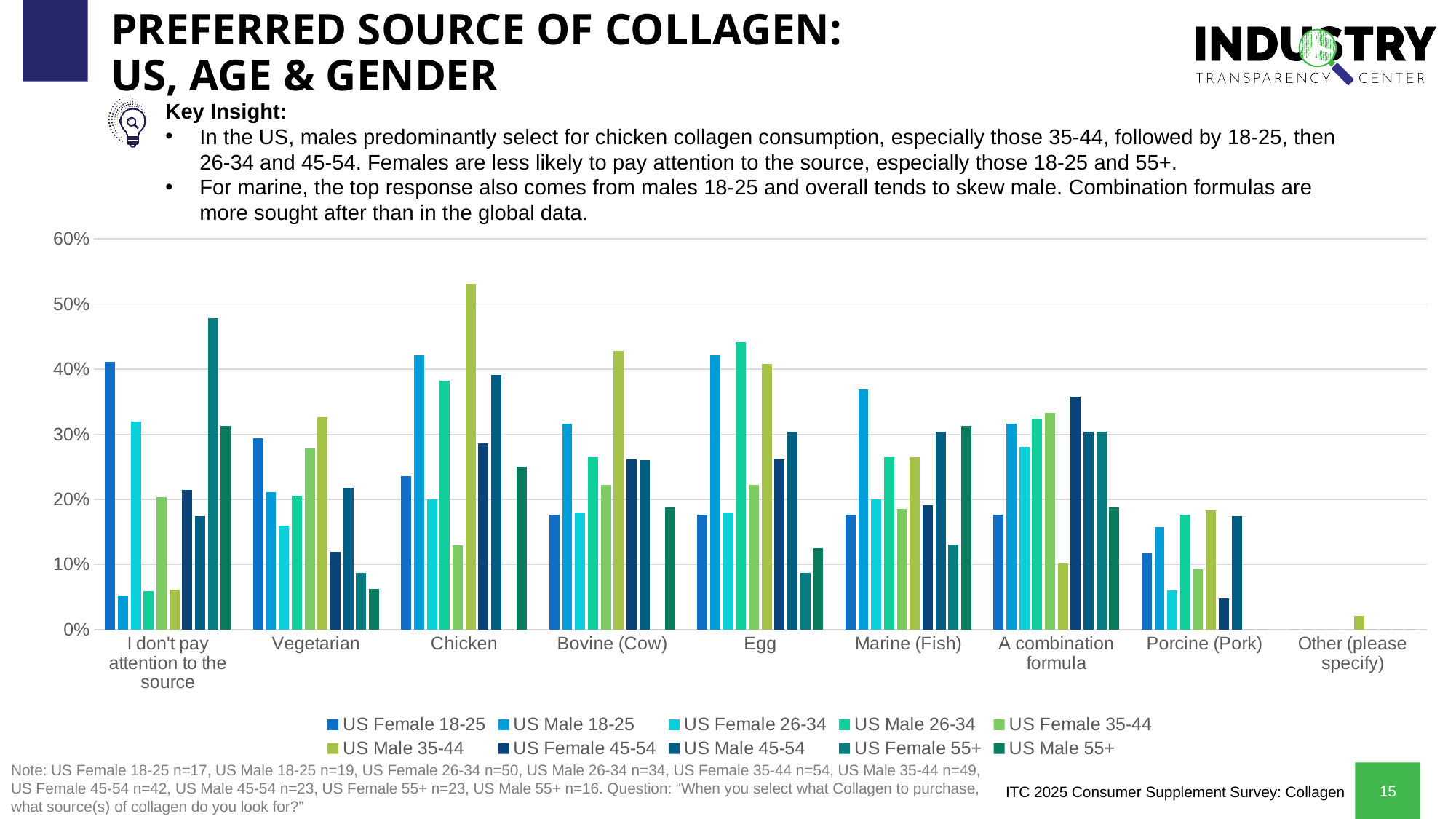
Is the value for US Male 35-44 in the Chicken category greater or less than 50%? greater Which series has the tallest bar in the Chicken category? US Male 35-44 Is the value for US Female 45-54 in the Porcine (Pork) category greater or less than 10%? less In the Egg category, which is larger: US Male 26-34 or US Female 26-34? US Male 26-34 Which category has only a single visible bar? Other (please specify) Is the value for US Female 55+ in the 'I don't pay attention to the source' category greater or less than 40%? greater Which series has the tallest bar in the Marine (Fish) category? US Male 18-25 How many series does the legend list? 10 What kind of chart is shown on the slide? bar chart How many collagen source categories are shown on the x axis? 9 In the Chicken category, which is larger: US Male 35-44 or US Female 35-44? US Male 35-44 Which series has the tallest bar in the 'I don't pay attention to the source' category? US Female 55+